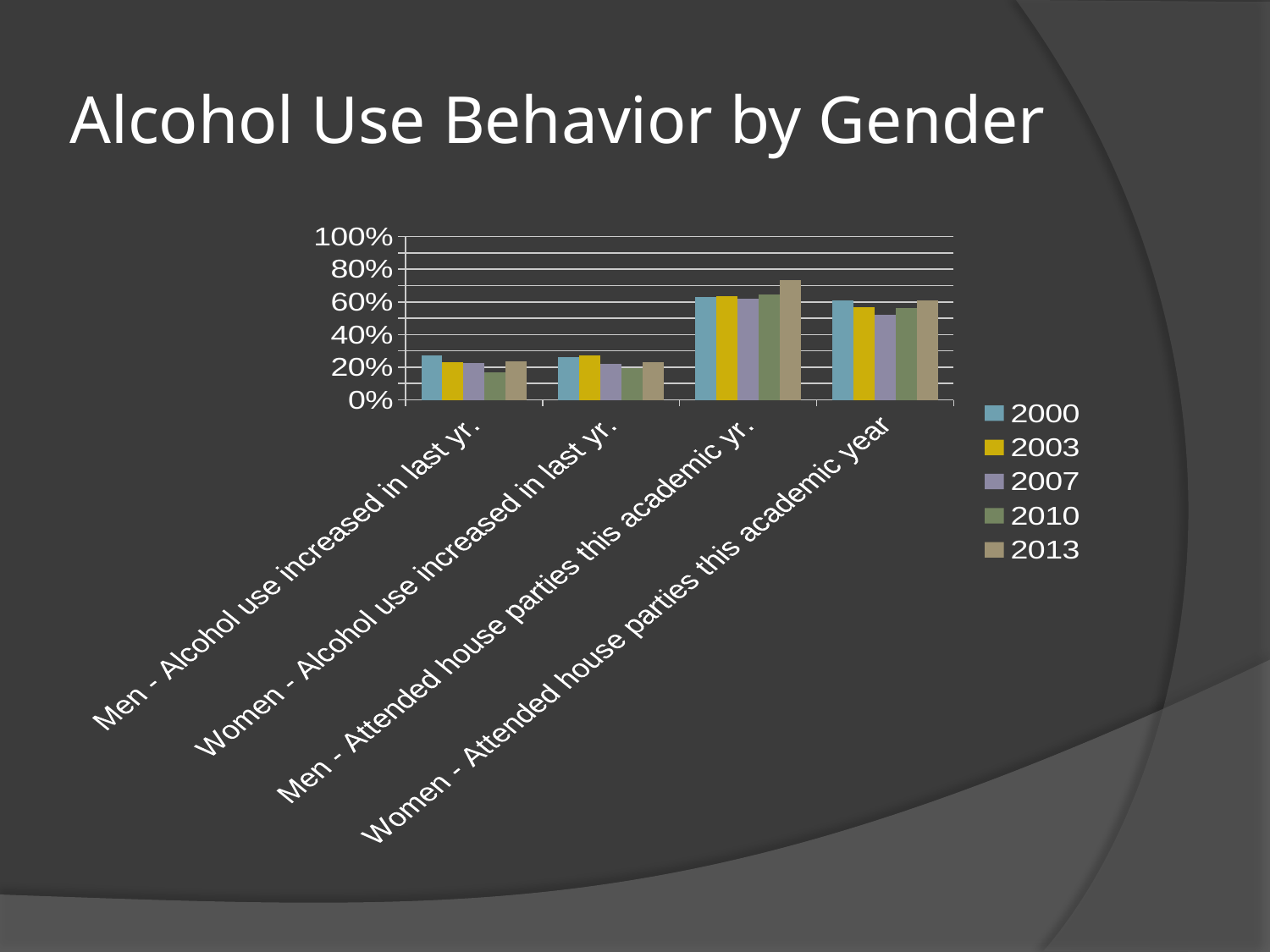
Is the value for 2003 in the 'Women - Alcohol use increased in last yr.' category greater or less than 20%? greater Is the value for 2010 in the 'Men - Alcohol use increased in last yr.' category greater or less than 20%? less How many series does the legend list? 5 How many categories are shown on the x axis? 4 For 2013, which is larger: the value for 'Men - Attended house parties this academic yr.' or 'Women - Attended house parties this academic year'? Men - Attended house parties this academic yr. Is the value for 2007 in the 'Women - Attended house parties this academic year' category greater or less than 60%? less Within the 'Men - Alcohol use increased in last yr.' category, which year has the lowest value? 2010 Which year does the legend list last? 2013 What is the title of the slide containing the chart? Alcohol Use Behavior by Gender Within the 'Men - Attended house parties this academic yr.' category, which year has the highest value? 2013 What kind of chart is shown on the slide? bar chart